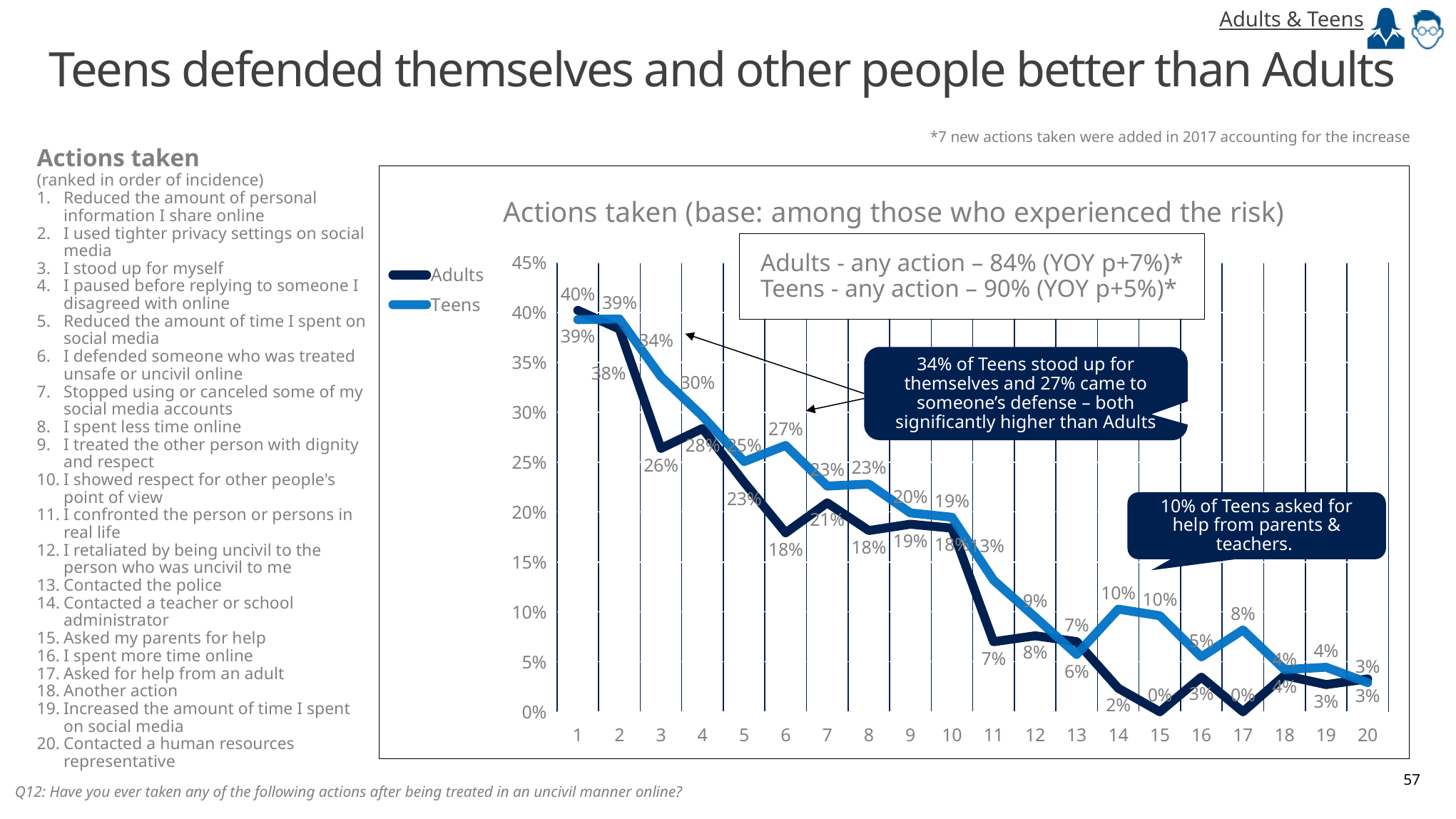
How many series does the chart legend list? 2 What is the value for Adults at action 3? 26% What is the difference between the Teens and Adults values at action 3? 8 percentage points At action 6, which series has the larger value, Adults or Teens? Teens Do the values generally rise or fall moving from action 1 to action 20? Fall What kind of chart is shown on the slide? Line chart At which action does the Adults series reach its highest value? 1 What is the value for Teens at action 3? 34% What is the value for Adults at action 1? 40% What is the title of the chart? Actions taken (base: among those who experienced the risk) How many actions (points) are plotted along the x axis of the chart? 20 What is the value for Teens at action 6? 27%